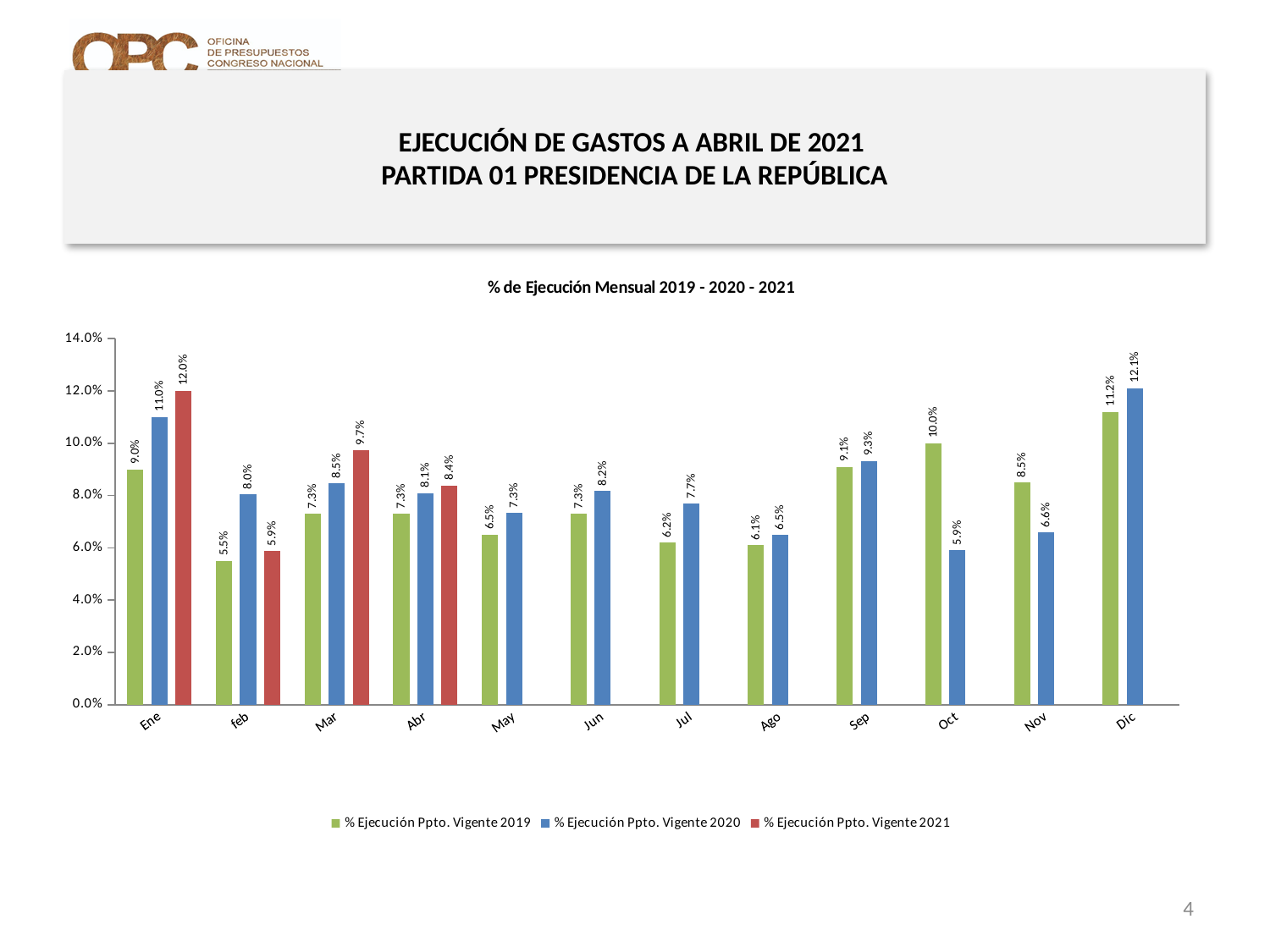
Which month has the highest % Ejecución Ppto. Vigente 2019 value? Dic What is the difference between the 2021 and 2019 values for Mar? 2.4% What is the title of the chart? % de Ejecución Mensual 2019 - 2020 - 2021 What is the % Ejecución Ppto. Vigente 2021 value for Ene? 12.0% How many months have a % Ejecución Ppto. Vigente 2021 bar? 4 How many series does the legend list? 3 Which month has the lowest % Ejecución Ppto. Vigente 2020 value? Oct What kind of chart is shown on the slide? Bar chart How many months are shown on the x axis? 12 What is the % Ejecución Ppto. Vigente 2020 value for Dic? 12.1% What is the % Ejecución Ppto. Vigente 2019 value for Oct? 10.0% For Oct, which is larger: the 2019 value or the 2020 value? 2019